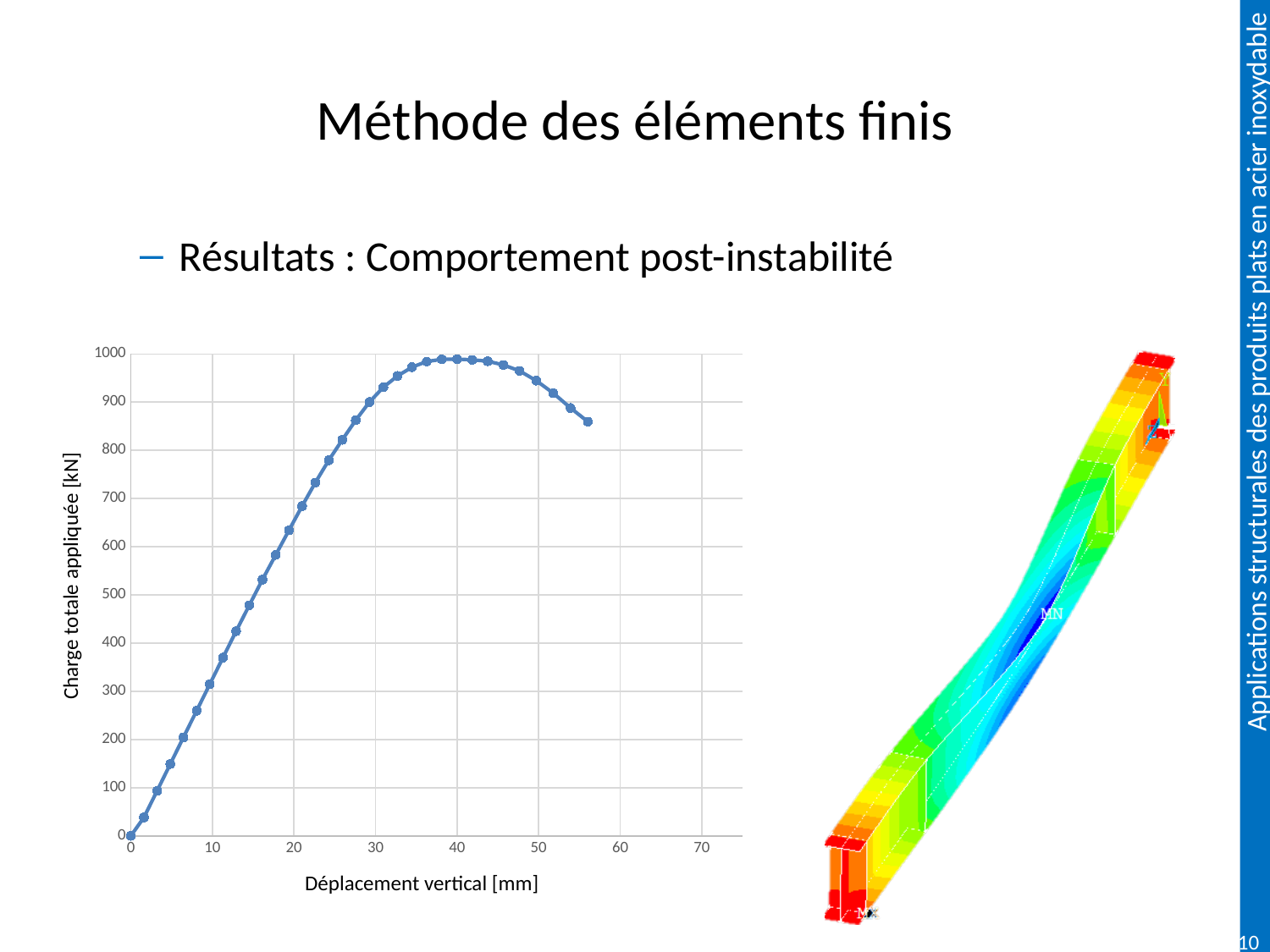
Is the maximum applied load reached on the curve greater or less than 900 kN? greater What kind of chart is shown on the slide? line chart Is the applied load at a vertical displacement of 20 mm greater or less than 600 kN? greater What is the label of the horizontal axis of the chart? Déplacement vertical [mm] Is the applied load at the last point of the curve greater or less than 900 kN? less Does the applied load rise or fall as the vertical displacement increases from 45 mm to the end of the curve? fall Does the applied load rise or fall as the vertical displacement increases from 0 to 30 mm? rise What is the label of the vertical axis of the chart? Charge totale appliquée [kN]